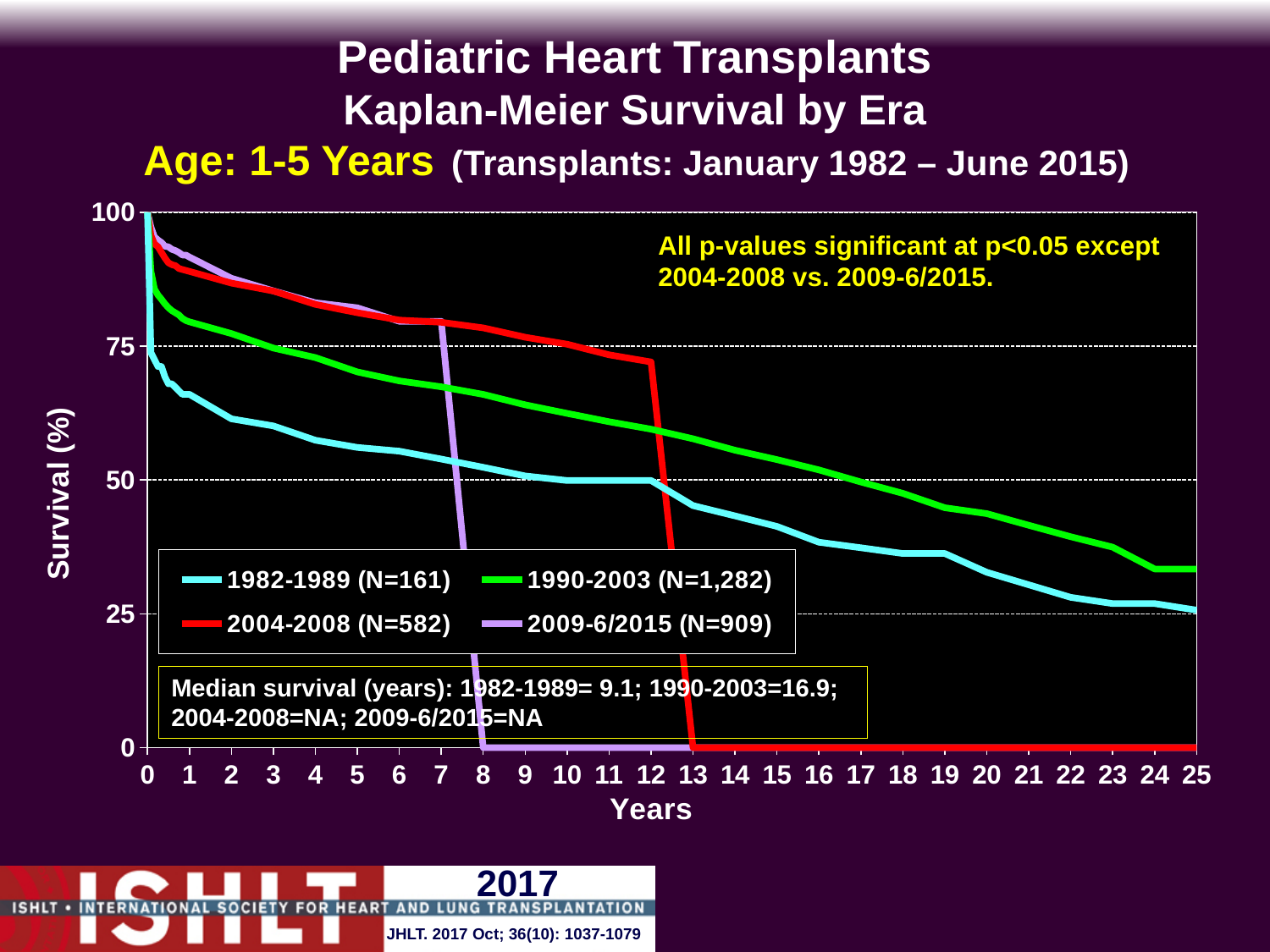
What is the median survival in years for the 1990-2003 era, as stated on the slide? 16.9 Is the survival value for the 2004-2008 era at 5 years greater or less than 75? greater Is the survival value for the 1990-2003 era at 10 years greater or less than 50? greater Is the survival value for the 1982-1989 era at 20 years greater or less than 50? less How many series does the legend list? 4 At 5 years, which era has higher survival: 1990-2003 or 1982-1989? 1990-2003 What is the N for the 1990-2003 era shown in the legend? 1,282 Do the survival curves rise or fall as years increase along the x axis? fall At 10 years, which era has the highest survival? 2004-2008 What is the N for the 2009-6/2015 era shown in the legend? 909 What kind of chart is shown on the slide? line chart